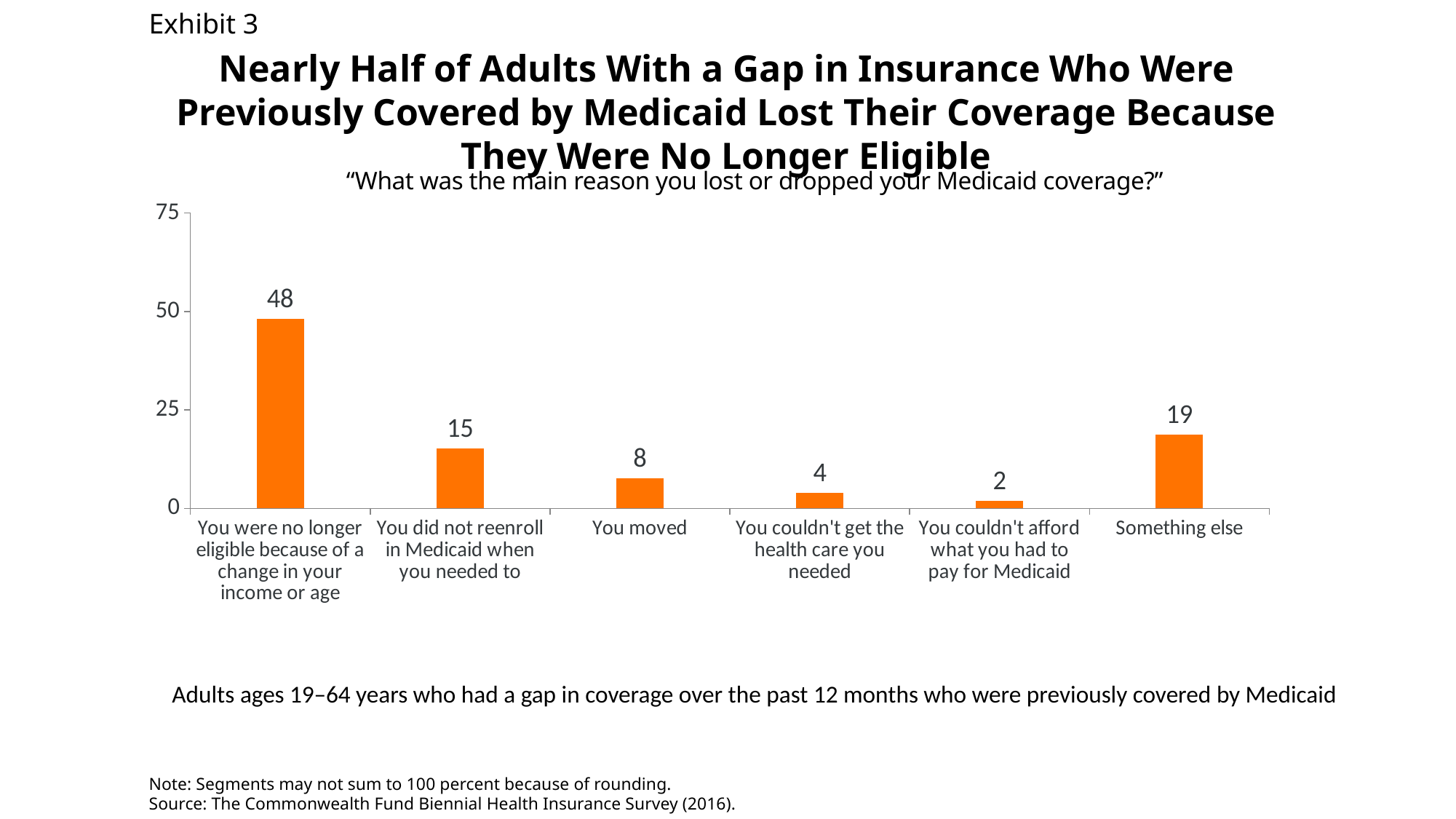
What is the value for "You moved"? 8 What is the value for "You did not reenroll in Medicaid when you needed to"? 15 Which is larger: the value for "You did not reenroll in Medicaid when you needed to" or the value for "Something else"? Something else What is the value for "You couldn't afford what you had to pay for Medicaid"? 2 What kind of chart is shown on the slide? Bar chart How many categories are shown on the chart? 6 What survey question is shown as the chart's subtitle? "What was the main reason you lost or dropped your Medicaid coverage?" What is the difference between the values for "You were no longer eligible because of a change in your income or age" and "Something else"? 29 What is the value for "You were no longer eligible because of a change in your income or age"? 48 What is the value for "Something else"? 19 Which category has the highest value? You were no longer eligible because of a change in your income or age Which category has the lowest value? You couldn't afford what you had to pay for Medicaid